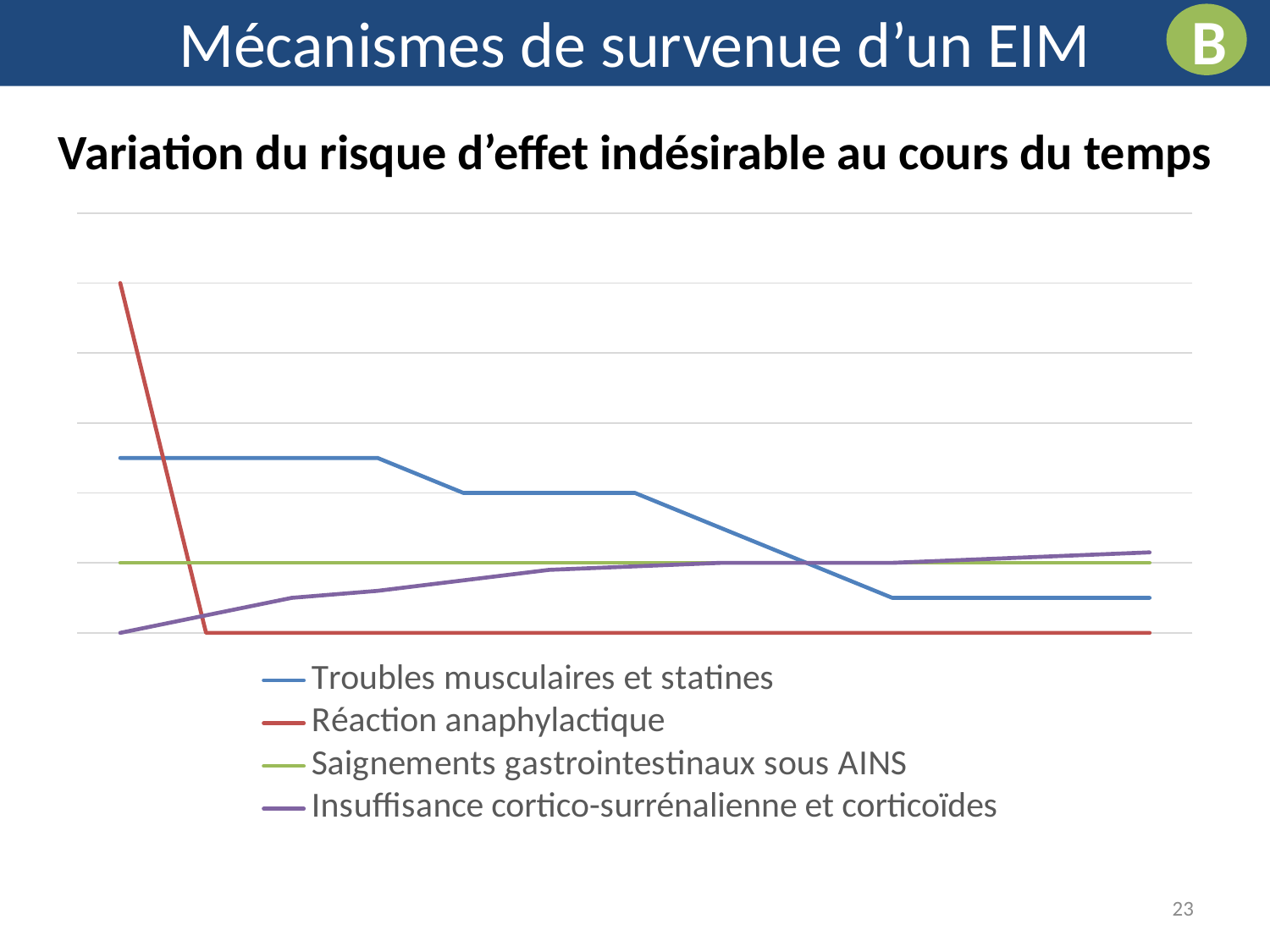
Does the line for Saignements gastrointestinaux sous AINS rise, fall or stay flat along the x axis? stay flat Which series is drawn in red? Réaction anaphylactique At the end of the x axis, which is larger: Troubles musculaires et statines or Saignements gastrointestinaux sous AINS? Saignements gastrointestinaux sous AINS What is the title of the chart? Variation du risque d'effet indésirable au cours du temps Does the line for Troubles musculaires et statines rise or fall along the x axis? fall How many series does the legend list? 4 At the start of the x axis, which is larger: Troubles musculaires et statines or Insuffisance cortico-surrénalienne et corticoïdes? Troubles musculaires et statines Which series has the highest value at the start of the x axis? Réaction anaphylactique Does the line for Insuffisance cortico-surrénalienne et corticoïdes rise or fall along the x axis? rise What kind of chart is shown on the slide? line chart Which series has the lowest value at the end of the x axis? Réaction anaphylactique